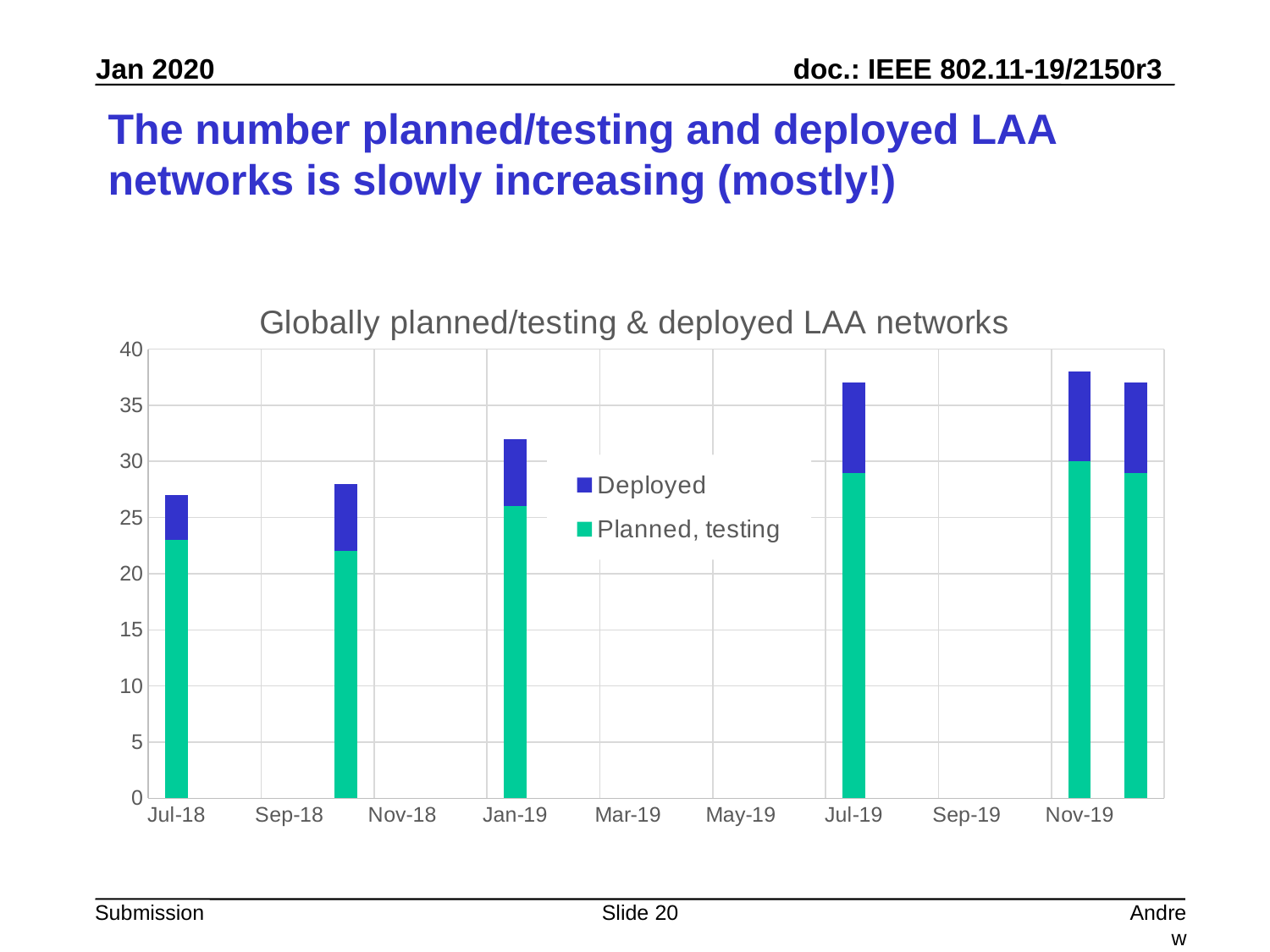
How many series does the chart's legend list? 2 Is the 'Planned, testing' value for Jul-19 greater or less than 25? greater Is the total height of the Jul-19 bar greater or less than 35? greater Is the total height of the Jul-18 bar greater or less than 30? less What is the title of the chart? Globally planned/testing & deployed LAA networks Which series is shown in green in the chart? Planned, testing Which bar is taller in total, Jan-19 or Jul-19? Jul-19 How many bars are plotted in the chart? 6 What kind of chart is shown on the slide? Stacked bar chart Do the total bar heights generally rise or fall from Jul-18 to Nov-19? rise